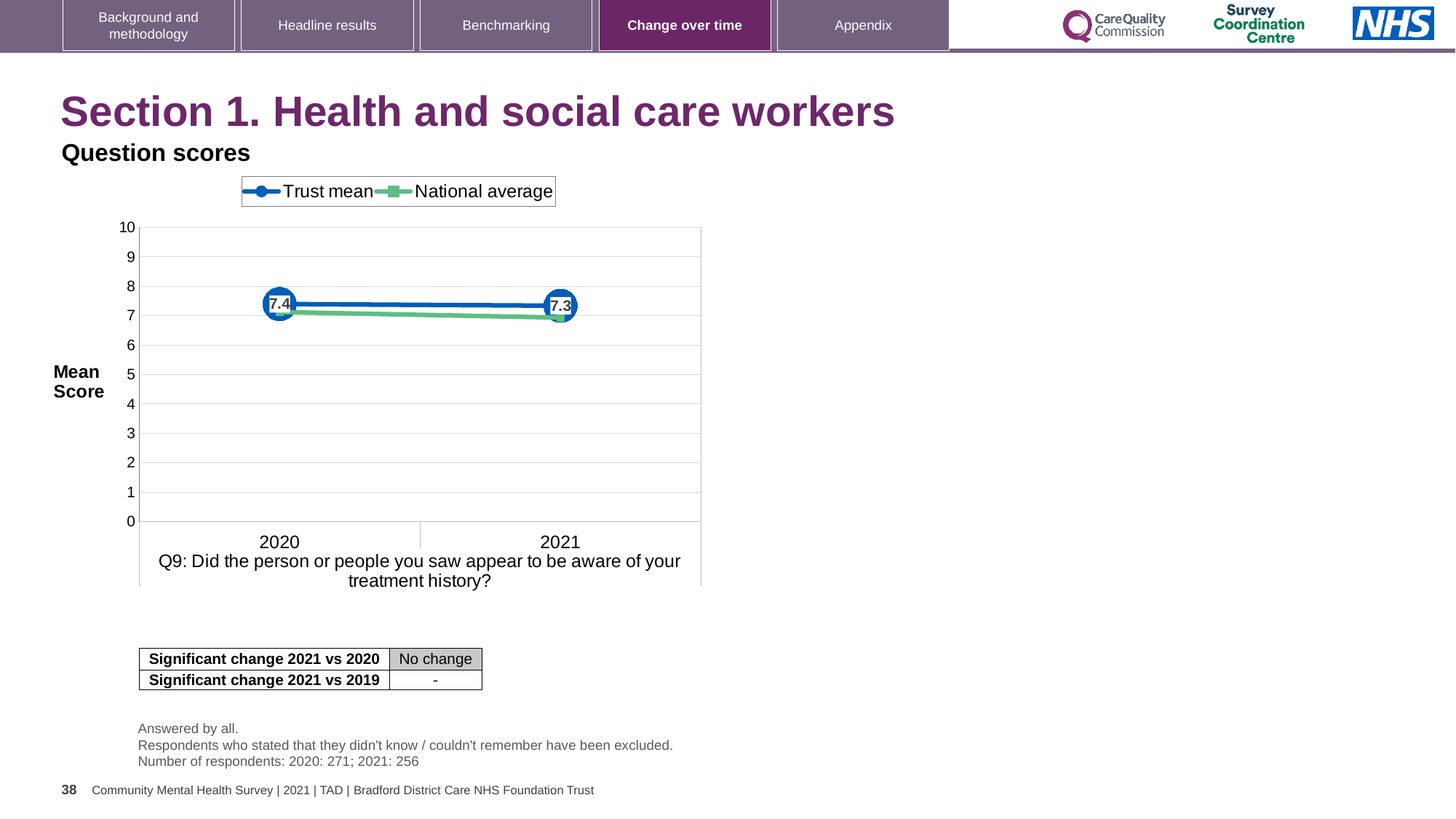
How many series does the chart legend list? 2 What is the Trust mean score for 2021? 7.3 Is the National average value for 2020 greater or less than 6? greater How many years are shown on the x axis of the chart? 2 Is the National average value for 2021 greater or less than 8? less What is the Trust mean score for 2020? 7.4 In which year is the Trust mean score lower? 2021 In which year is the Trust mean score higher, 2020 or 2021? 2020 Does the Trust mean rise or fall from 2020 to 2021? Fall What kind of chart is shown on the slide? Line chart What is the difference between the Trust mean scores for 2020 and 2021? 0.1 In 2021, which is larger, the Trust mean or the National average? Trust mean